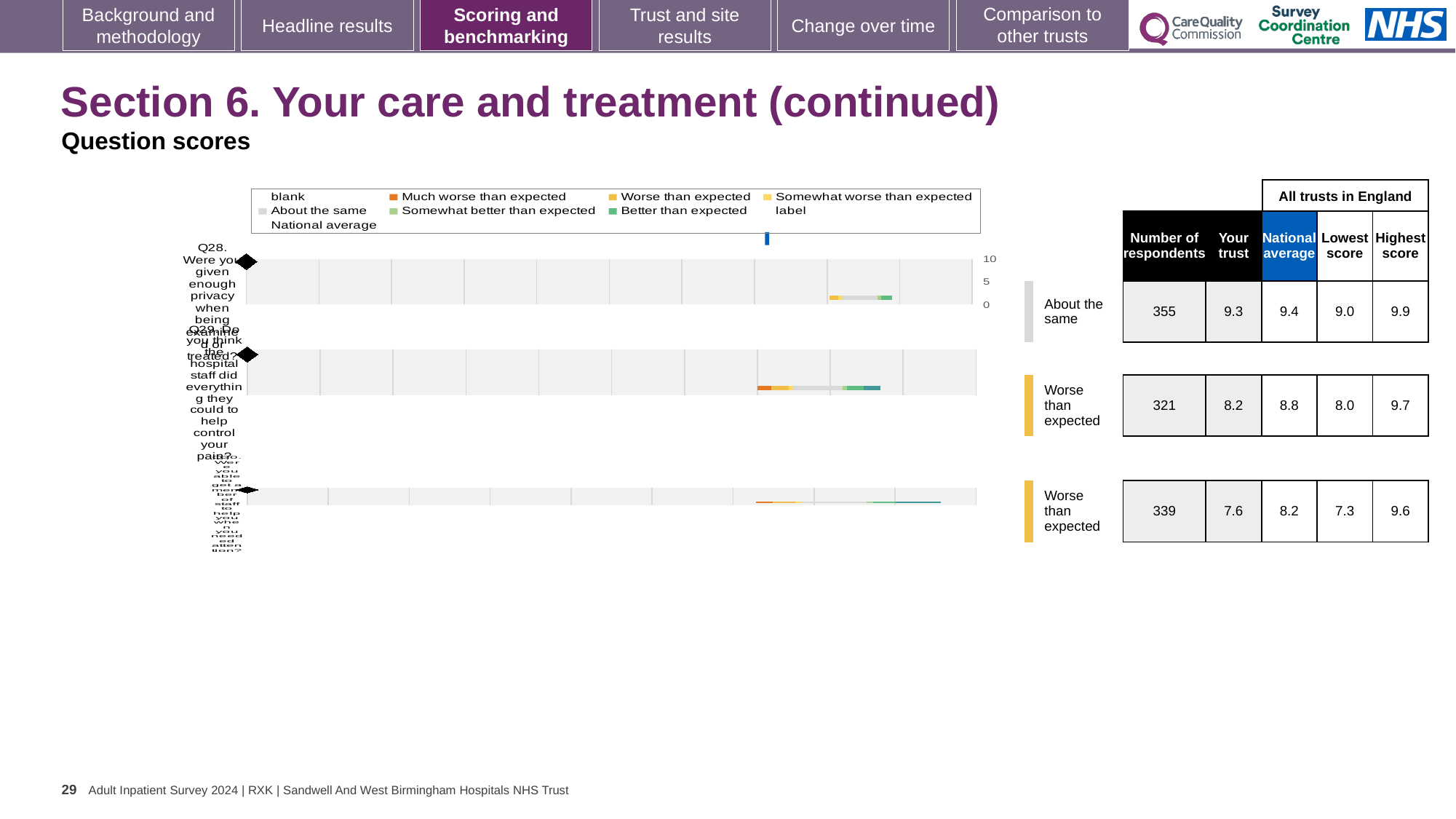
What is the trust's score for Q28 (Were you given enough privacy when being examined or treated?)? 9.3 Is the trust's score for Q28 greater or less than 5? greater What kind of chart is used to show the question scores on this slide? bar chart Which has the higher trust score, Q28 or Q29? Q28 How many respondents answered Q28? 355 Which of the plotted questions has the highest trust score? Q28 What is the national average score for Q29 (Do you think the hospital staff did everything they could to help control your pain?)? 8.8 How many questions (rows) are plotted in the chart? 3 What is the highest score among all trusts in England for Q28? 9.9 What is the difference between the national average and the trust's score for Q29? 0.6 Which benchmark category is the trust's score for Q29 placed in? Worse than expected Which benchmark category is the trust's score for Q28 placed in? About the same